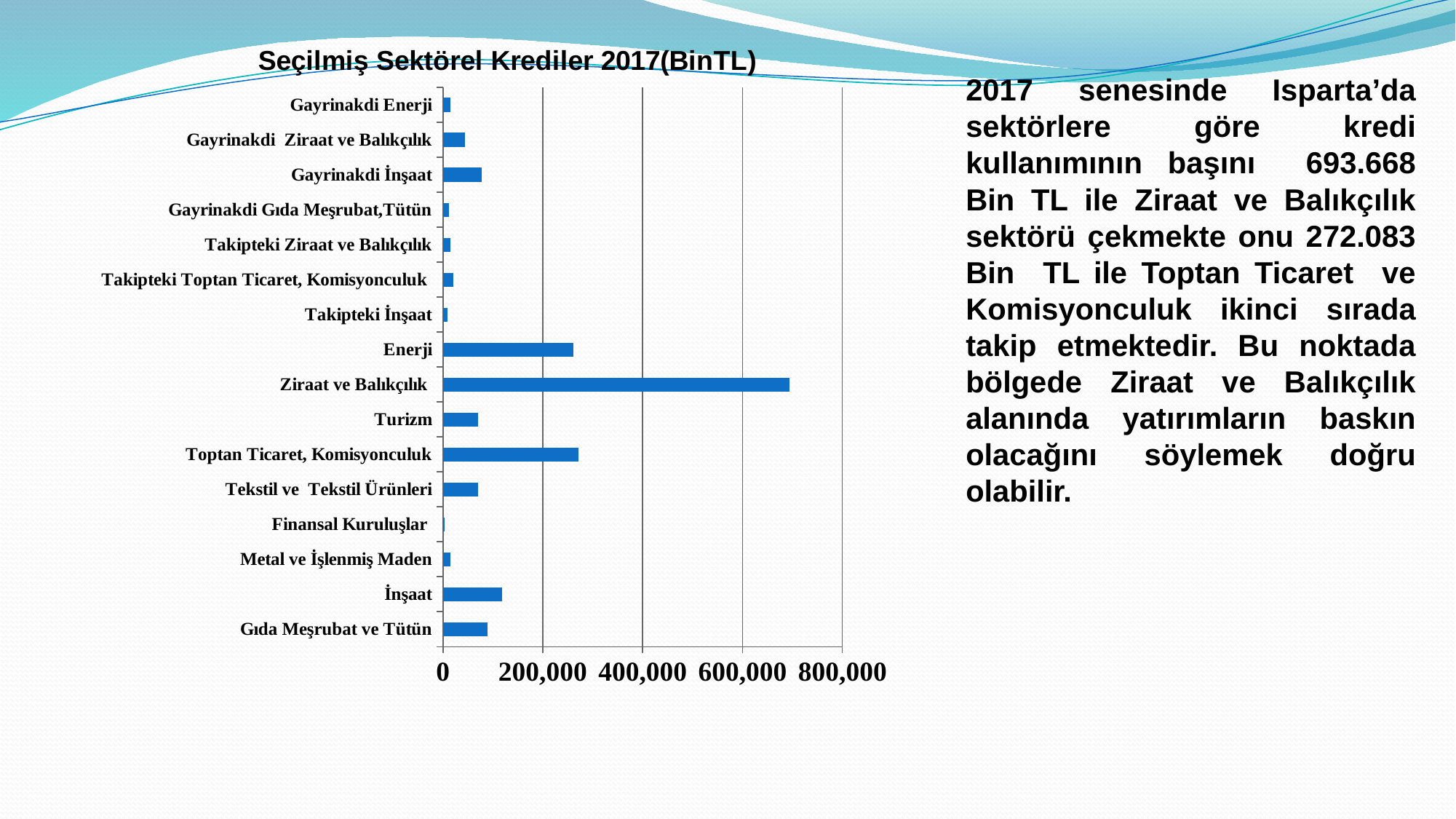
Which sector has the highest value in the chart? Ziraat ve Balıkçılık Which is larger, the value for İnşaat or the value for Turizm? İnşaat What kind of chart is shown on the slide? bar chart Is the value for Ziraat ve Balıkçılık greater or less than 600,000? greater Is the value for Enerji greater or less than 200,000? greater Which is larger, the value for Ziraat ve Balıkçılık or the value for Enerji? Ziraat ve Balıkçılık Which sector has the lowest value in the chart? Finansal Kuruluşlar Which is larger, the value for Gayrinakdi İnşaat or the value for Gayrinakdi Enerji? Gayrinakdi İnşaat Is the value for İnşaat greater or less than 200,000? less What is the title of the chart? Seçilmiş Sektörel Krediler 2017(BinTL) How many sector categories are plotted in the chart? 16